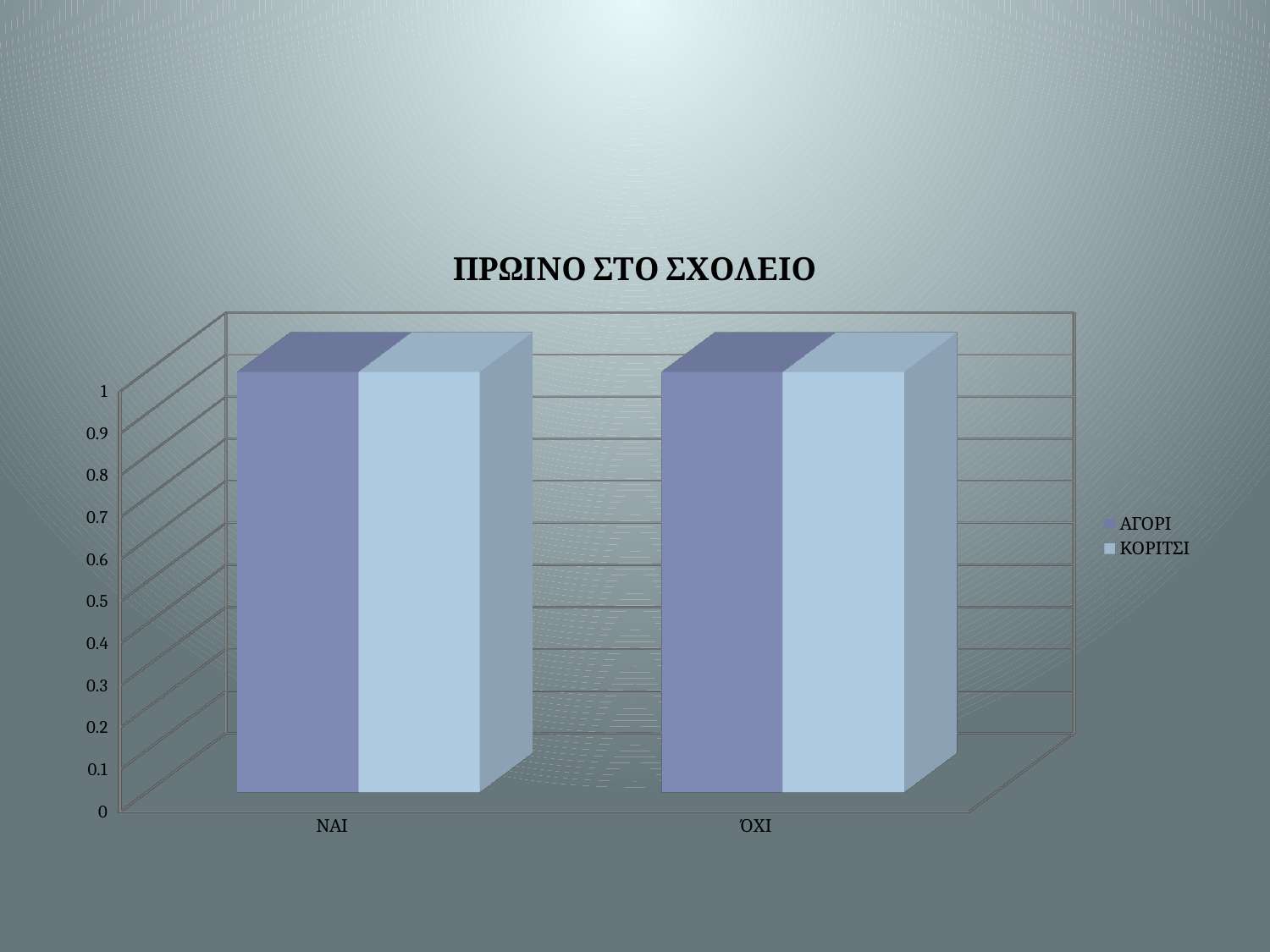
Is the value for ΑΓΟΡΙ in the ΝΑΙ category greater or less than 0.5? greater What is the highest value shown on the vertical axis? 1 What is the title of the chart? ΠΡΩΙΝΟ ΣΤΟ ΣΧΟΛΕΙΟ Is the value for ΚΟΡΙΤΣΙ in the ΝΑΙ category greater or less than 0.8? greater Is the value for ΚΟΡΙΤΣΙ in the ΌΧΙ category greater or less than 0.5? greater What kind of chart is shown on the slide? bar chart How many series does the legend list? 2 Which series are listed in the legend? ΑΓΟΡΙ and ΚΟΡΙΤΣΙ How many categories are shown on the x axis? 2